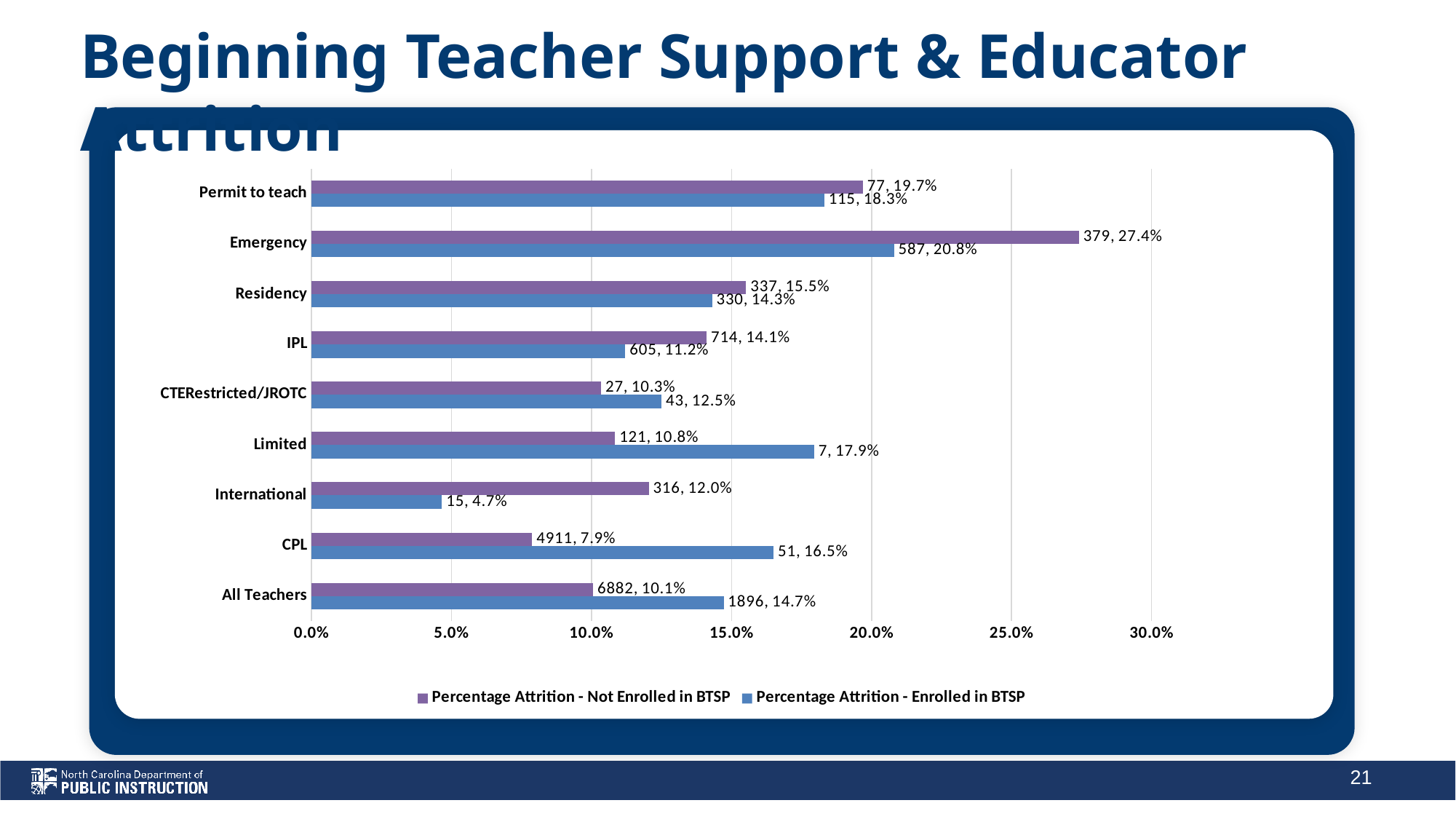
Is the percentage attrition for Limited teachers enrolled in BTSP greater or less than 15.0%? greater What is the percentage attrition for Emergency teachers not enrolled in BTSP? 27.4% What is the percentage attrition for All Teachers enrolled in BTSP? 14.7% What is the percentage attrition for International teachers enrolled in BTSP? 4.7% Which category has the lowest percentage attrition among teachers enrolled in BTSP? International How many teacher categories are shown on the chart? 9 How many series does the legend list? 2 What kind of chart is shown on the slide? Bar chart Which category has the highest percentage attrition among teachers not enrolled in BTSP? Emergency Which category has the lowest percentage attrition among teachers not enrolled in BTSP? CPL For Emergency teachers, what is the difference in percentage attrition between those not enrolled in BTSP and those enrolled in BTSP? 6.6 percentage points For CPL teachers, which is larger: the percentage attrition for those enrolled in BTSP or those not enrolled in BTSP? Enrolled in BTSP